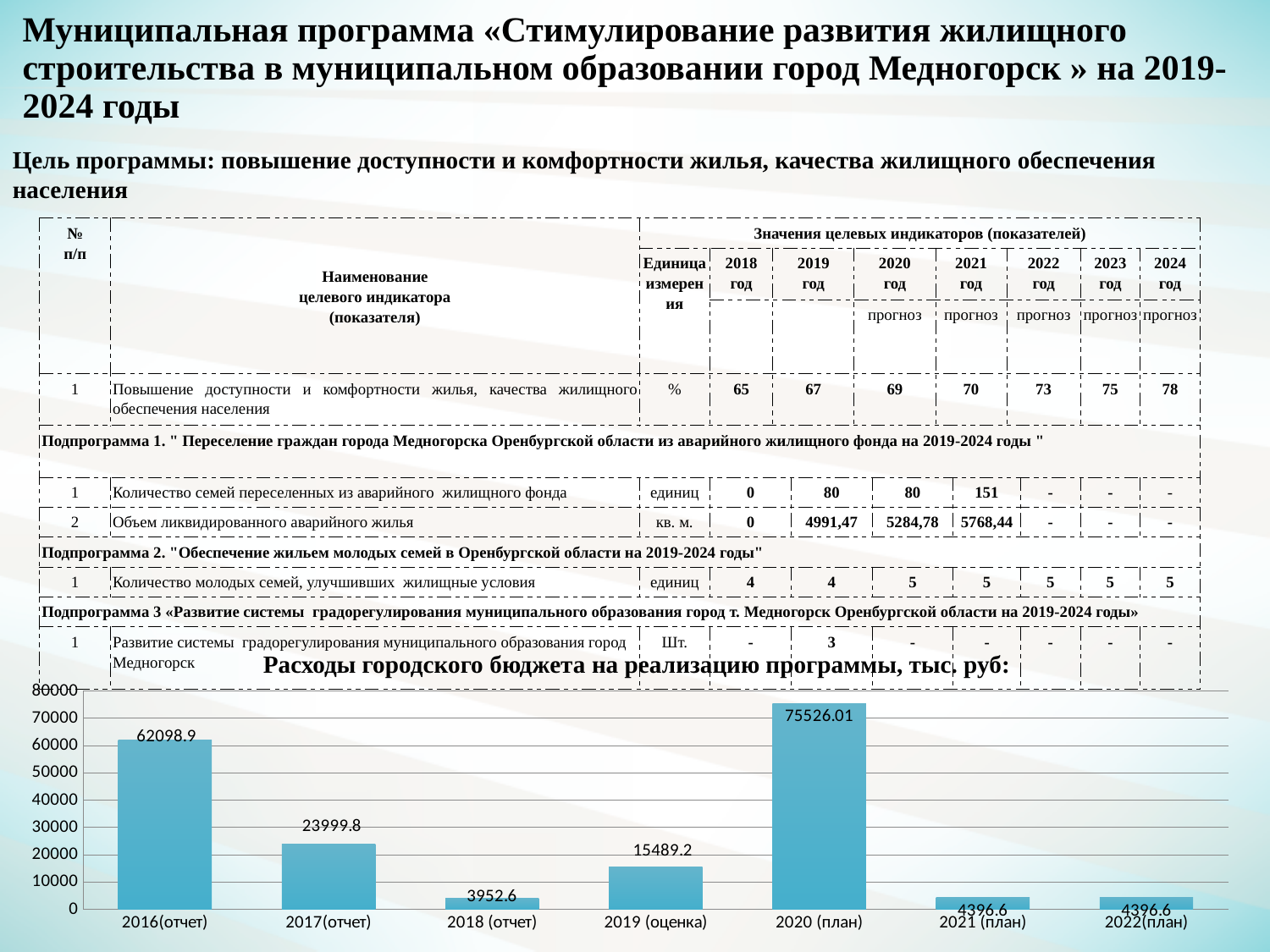
Which category has the lowest value in the chart? 2018 (отчет) Is the value for 2020 (план) greater or less than 70000? greater What type of chart is shown on the slide? bar chart What is the difference between the values for 2016(отчет) and 2017(отчет)? 38099.1 Which is larger, the value for 2019 (оценка) or the value for 2018 (отчет)? 2019 (оценка) What is the value for 2019 (оценка)? 15489.2 What is the title of the chart on the slide? Расходы городского бюджета на реализацию программы, тыс. руб: What is the value for 2017(отчет)? 23999.8 Which category has the highest value in the chart? 2020 (план) How many categories (years) are plotted in the chart? 7 What is the value for 2020 (план)? 75526.01 What is the value for 2016(отчет)? 62098.9